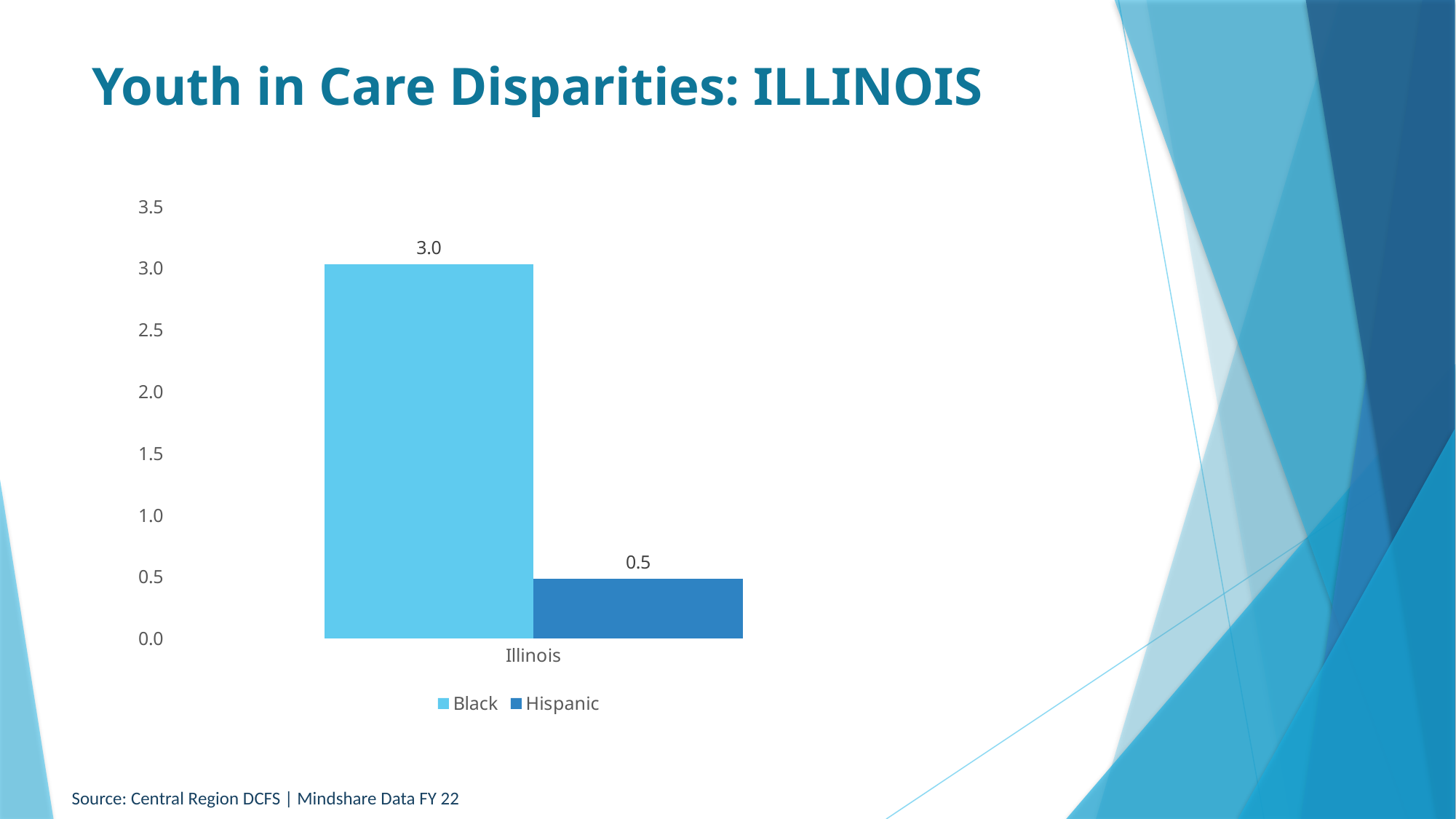
What is the value for Hispanic in Illinois? 0.5 What is the title of the slide? Youth in Care Disparities: ILLINOIS What is the highest value shown on the y axis? 3.5 What is the difference between the Black and Hispanic values for Illinois? 2.5 Is the value for Hispanic greater or less than 1.0? less Which series has the lowest value on the chart? Hispanic Which series has the higher value for Illinois, Black or Hispanic? Black Is the value for Black greater or less than 2.0? greater What kind of chart is shown on the slide? Bar chart How many series does the legend list? 2 How many categories are shown on the x axis? 1 What is the value for Black in Illinois? 3.0